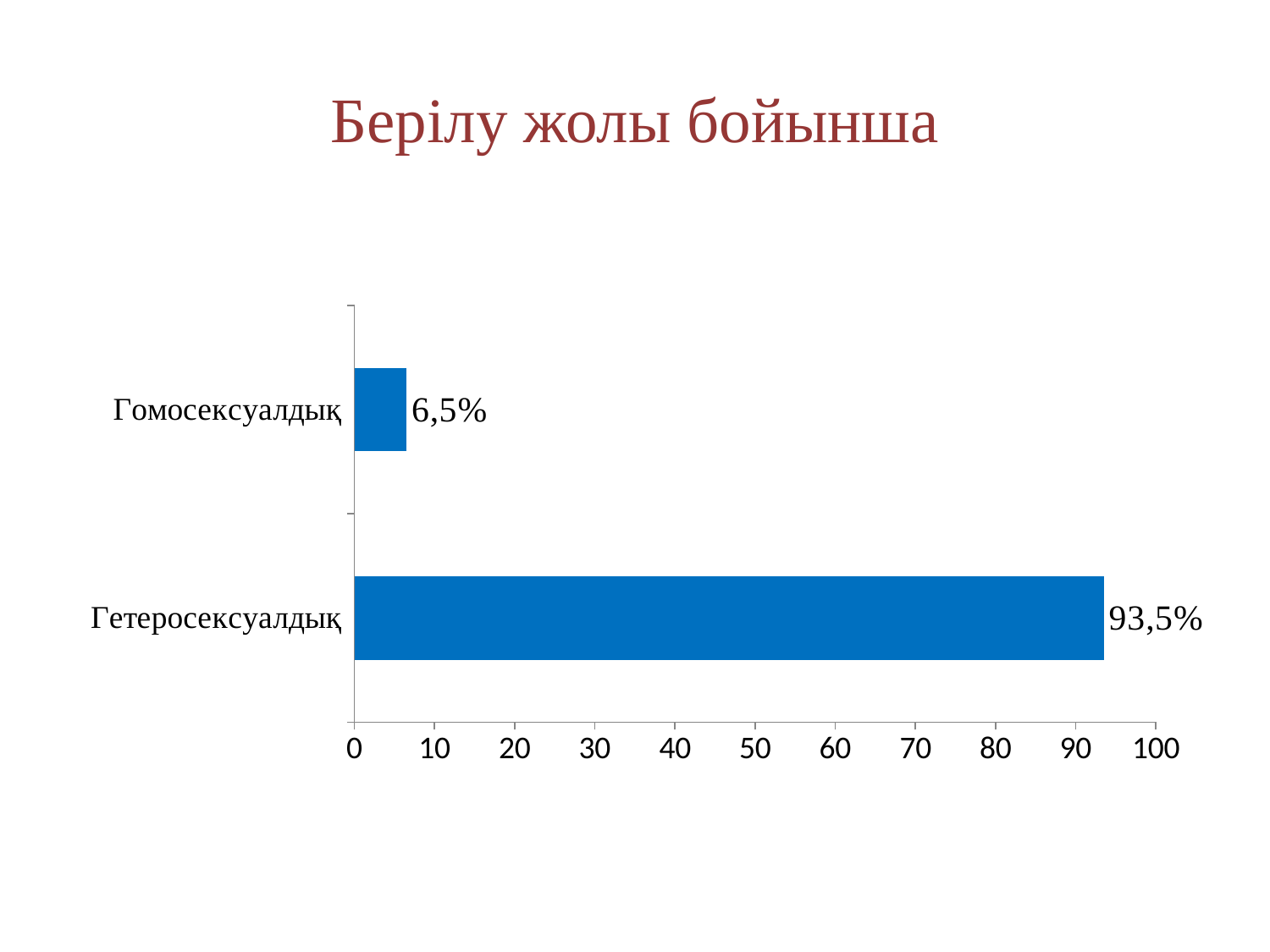
What is the maximum value shown on the horizontal axis? 100 What is the difference between the values for Гетеросексуалдық and Гомосексуалдық? 87% What is the value for Гетеросексуалдық? 93,5% Which is larger, the value for Гомосексуалдық or the value for Гетеросексуалдық? Гетеросексуалдық Which category has the highest value? Гетеросексуалдық How many categories are shown in the chart? 2 Which category has the lowest value? Гомосексуалдық Is the value for Гомосексуалдық greater or less than 10? less What is the value for Гомосексуалдық? 6,5% Is the value for Гетеросексуалдық greater or less than 90? greater What kind of chart is shown on the slide? bar chart What is the title of the slide? Берілу жолы бойынша